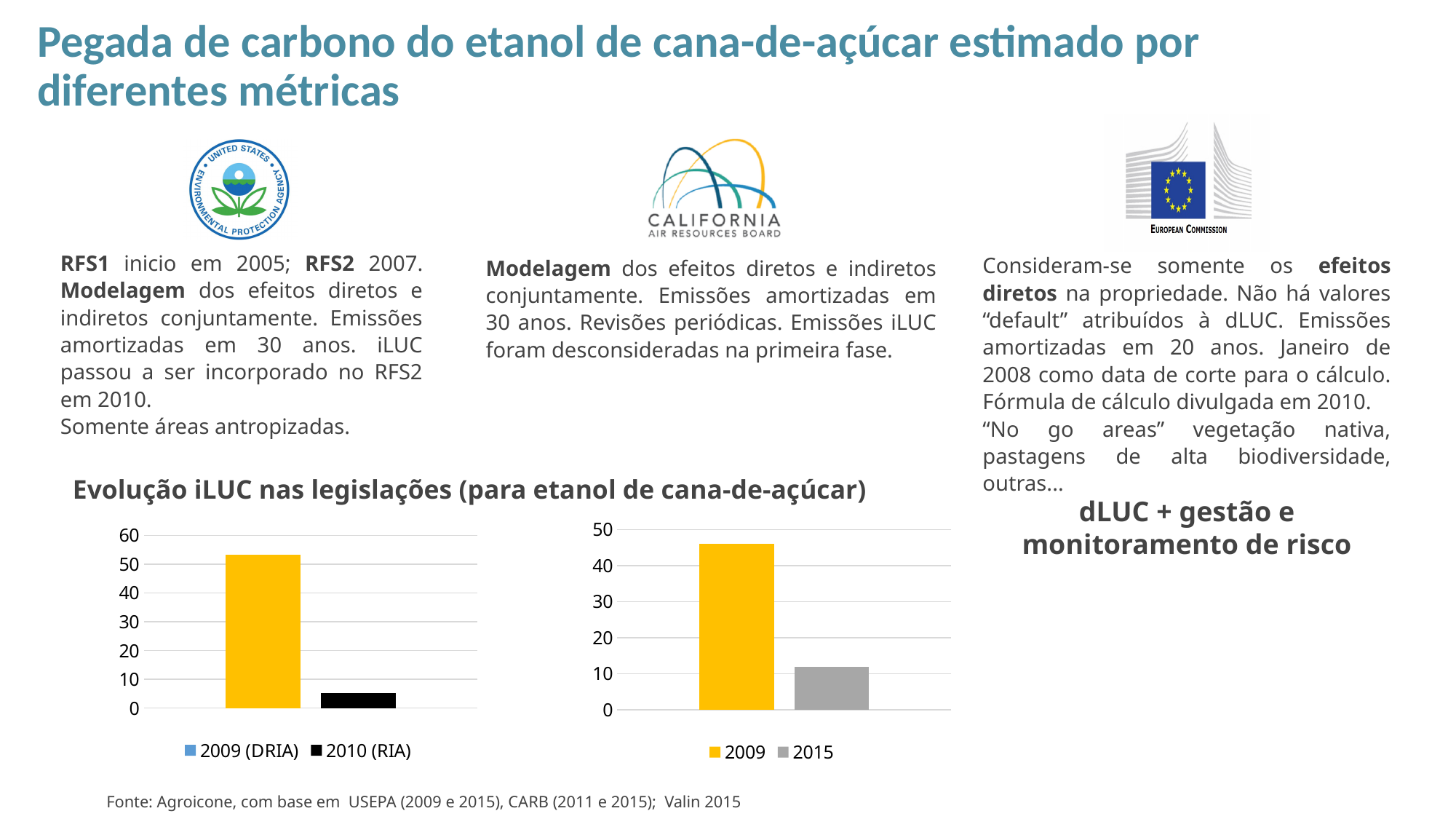
What type of chart is the right chart under 'Evolução iLUC nas legislações'? bar chart In the left chart under 'Evolução iLUC nas legislações', which series has the higher value, 2009 (DRIA) or 2010 (RIA)? 2009 (DRIA) In the right chart under 'Evolução iLUC nas legislações', how many series does the legend list? 2 In the right chart under 'Evolução iLUC nas legislações', do the values rise or fall from 2009 to 2015? fall In the right chart under 'Evolução iLUC nas legislações', is the value for 2015 greater or less than 20? less In the right chart under 'Evolução iLUC nas legislações', what is the highest value shown on the vertical axis? 50 In the left chart under 'Evolução iLUC nas legislações', is the value for 2010 (RIA) greater or less than 10? less In the left chart under 'Evolução iLUC nas legislações', how many series does the legend list? 2 In the left chart under 'Evolução iLUC nas legislações', is the value for 2009 (DRIA) greater or less than 50? greater In the right chart under 'Evolução iLUC nas legislações', which series has the lower value, 2009 or 2015? 2015 In the left chart under 'Evolução iLUC nas legislações', what is the highest value shown on the vertical axis? 60